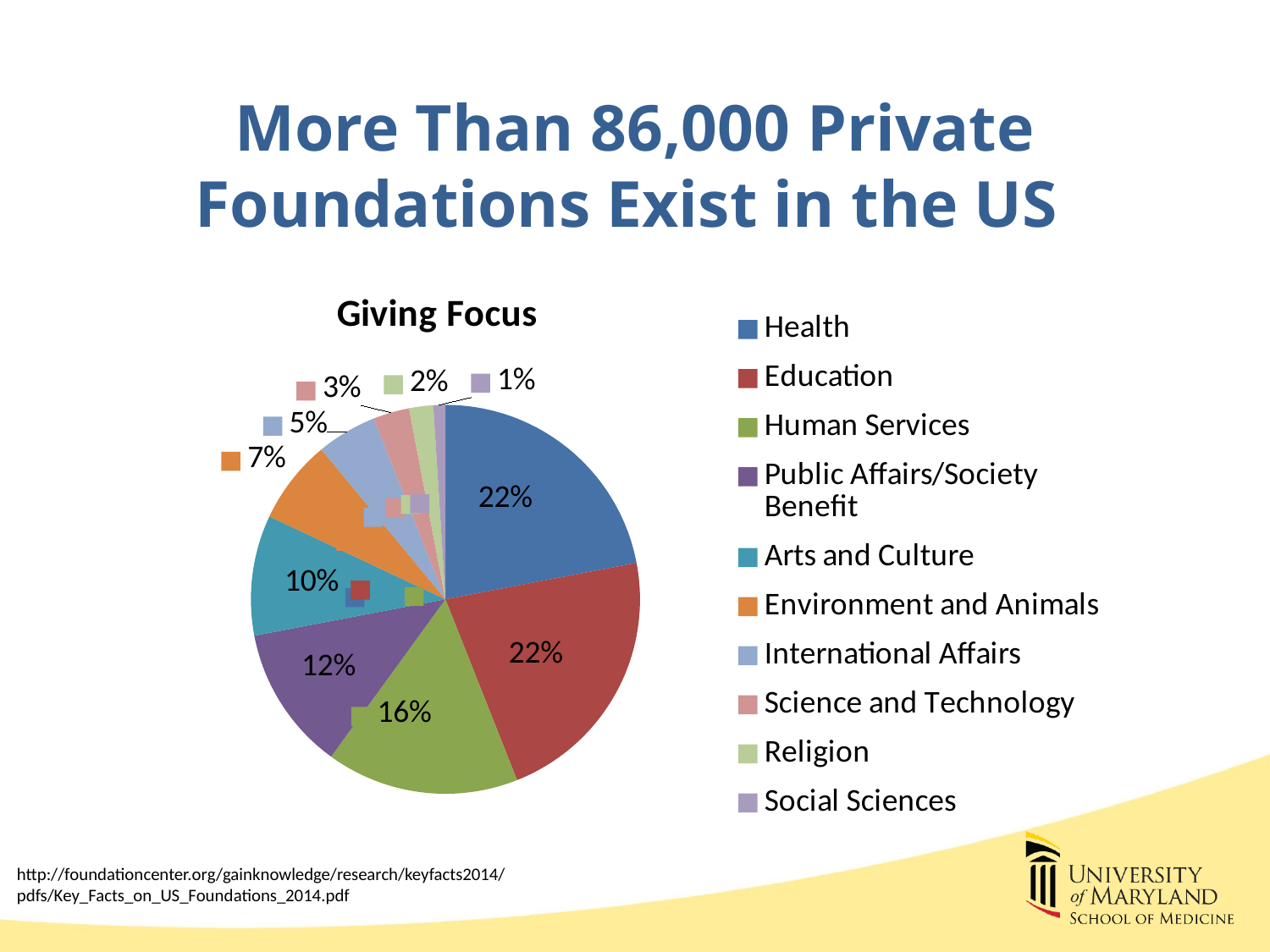
What percentage is shown for Environment and Animals? 7% How many categories does the legend list? 10 What share of giving focus goes to Human Services? 16% What is the title of the chart? Giving Focus Which category has the smallest slice of the pie? Social Sciences What is the difference between the Human Services share and the Arts and Culture share? 6% What is the combined share of Religion and Social Sciences? 3% Which is larger, the share for Environment and Animals or the share for Science and Technology? Environment and Animals What percentage is shown for International Affairs? 5% What type of chart is shown on the slide? pie chart What percentage is shown for Public Affairs/Society Benefit? 12% What percentage is shown for Arts and Culture? 10%